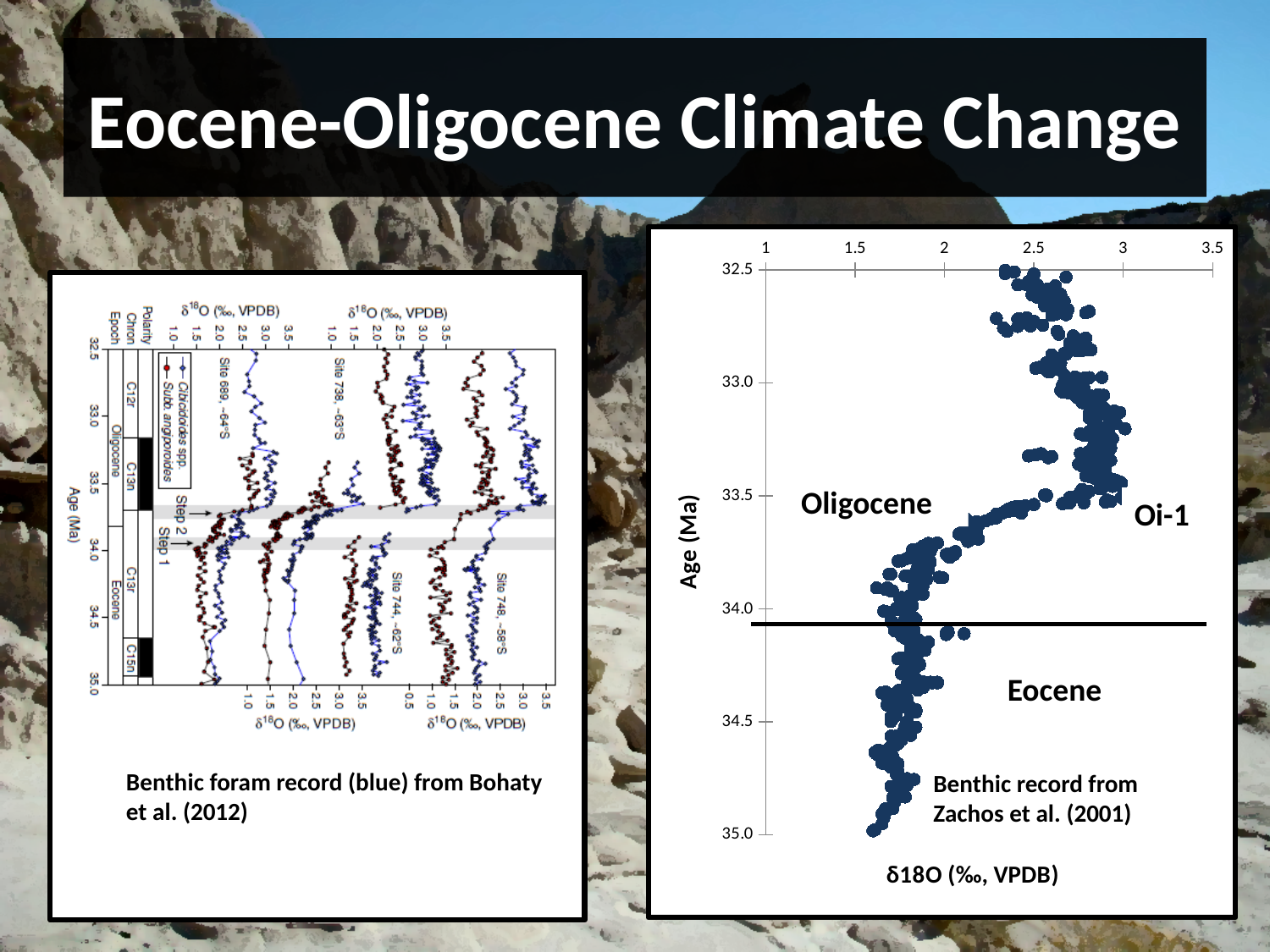
What kind of chart is the chart on the right of the slide (Benthic record from Zachos et al. (2001))? scatter chart On the right-hand chart, do δ18O values rise or fall as age decreases from 35.0 Ma to 33.0 Ma? rise On the left-hand chart (Bohaty et al. (2012)), how many series does the legend list? 2 On the left-hand chart (Bohaty et al. (2012)), how many drilling sites are plotted? 4 On the right-hand chart, is the δ18O value at an age of 34.5 Ma greater or less than 2? less On the right-hand chart, is the δ18O value at an age of 33.0 Ma greater or less than 2.5? greater On the right-hand chart, are δ18O values larger in the Oligocene portion (above the horizontal line) or in the Eocene portion (below the line)? Oligocene On the right-hand chart, what is the title of the vertical axis? Age (Ma) On the right-hand chart, is the δ18O value at an age of 35.0 Ma greater or less than 2? less On the right-hand chart, what is the title of the horizontal axis? δ18O (‰, VPDB) On the right-hand chart, what is the largest value shown on the horizontal δ18O axis? 3.5